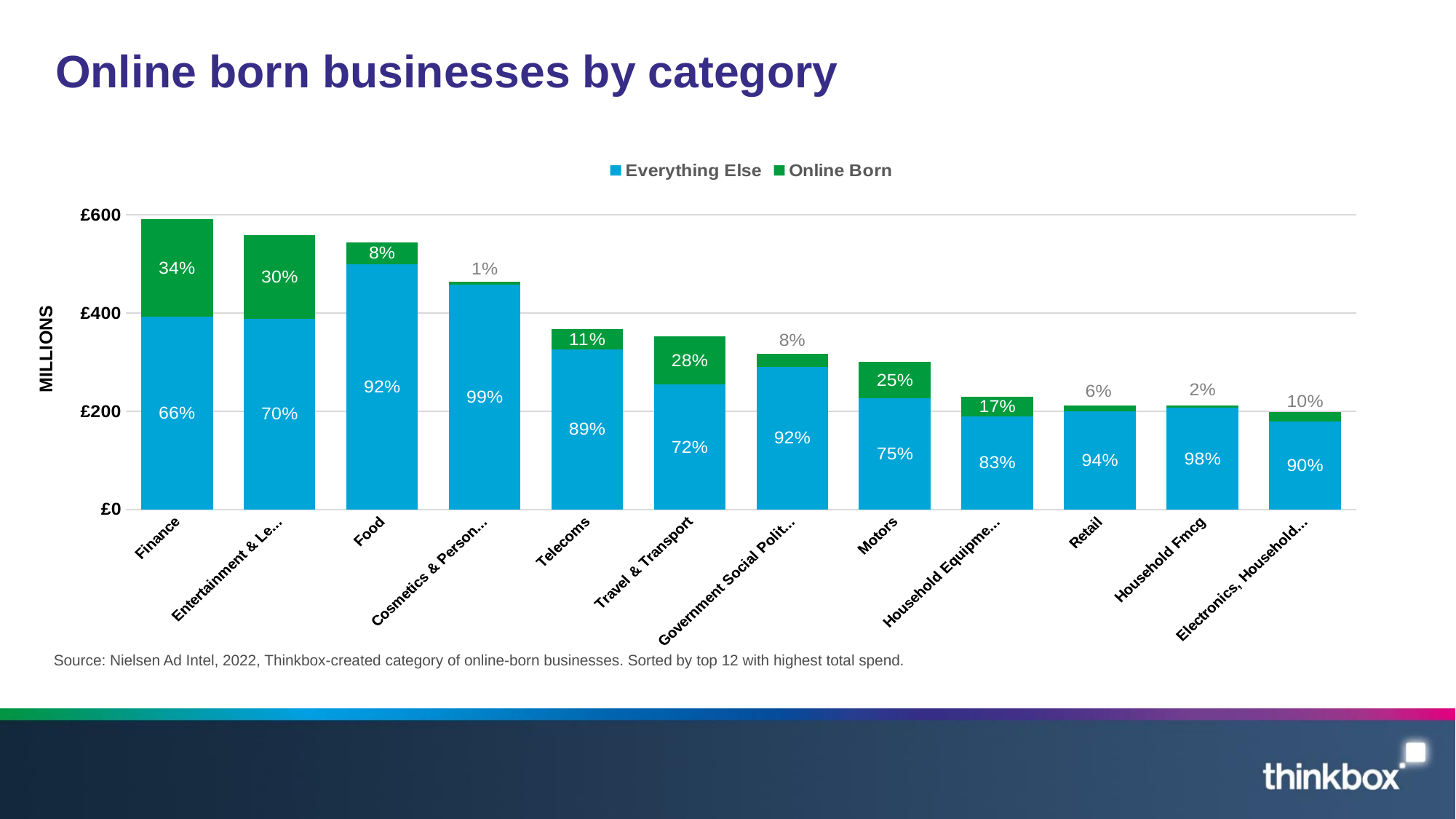
By how many percentage points does the Everything Else label exceed the Online Born label for Finance? 32 percentage points What percentage label is shown for the Online Born segment of the Travel & Transport bar? 28% How many categories are shown on the x axis? 12 How many series does the legend list? 2 Is the total value of the Telecoms bar greater or less than £400 million? less Is the total value of the Finance bar greater or less than £400 million? greater Which category has the highest Online Born percentage label? Finance Which category has the lowest Online Born percentage label? Cosmetics & Person... What percentage label is shown for the Online Born segment of the Finance bar? 34% Which has a larger Online Born percentage label, Motors or Household Equipme...? Motors What kind of chart is shown on the slide? Stacked bar chart What percentage label is shown for the Everything Else segment of the Telecoms bar? 89%